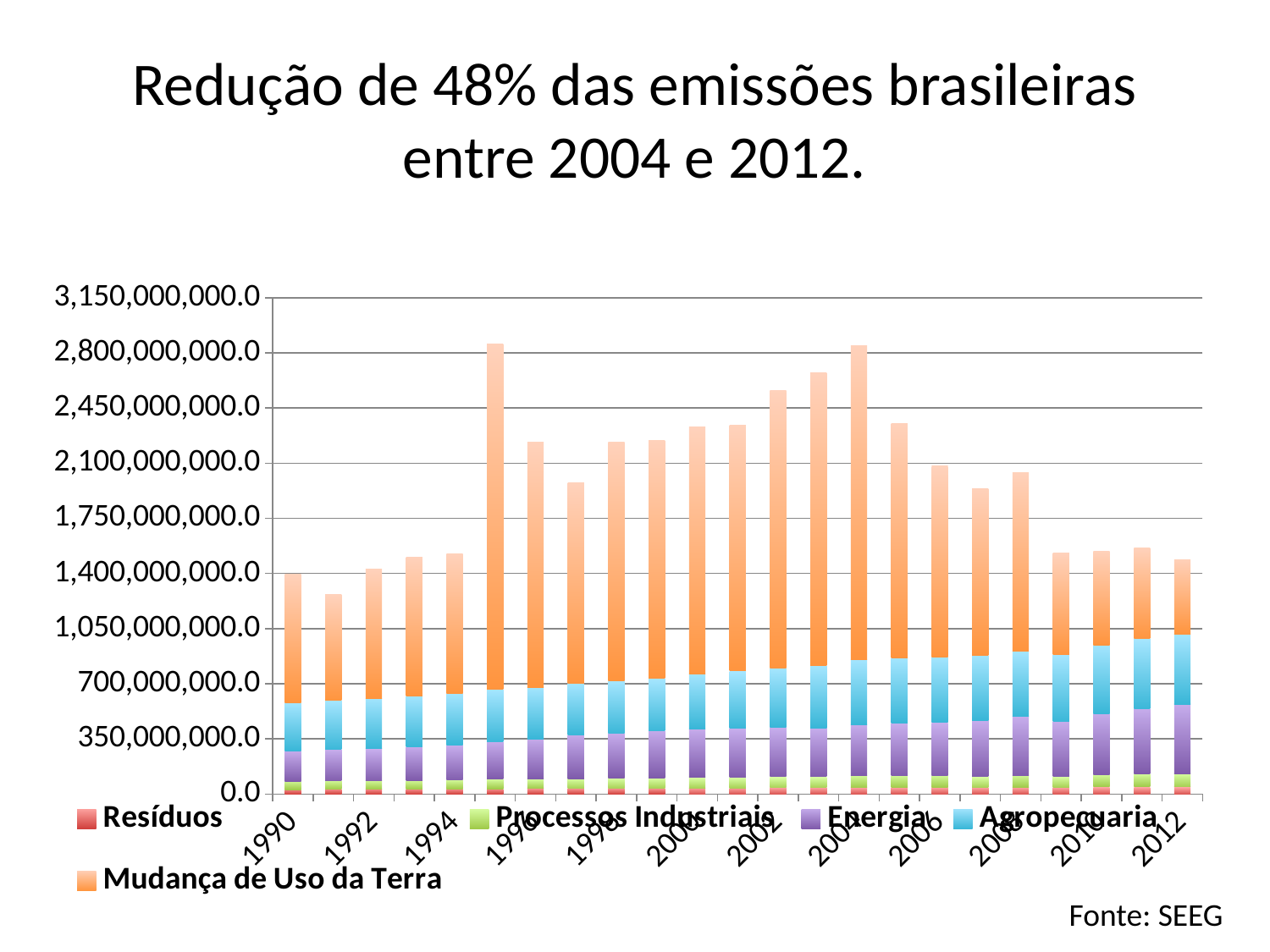
How many bars (years) are plotted in the chart? 23 What is the title of the slide? Redução de 48% das emissões brasileiras entre 2004 e 2012. Which year has the larger total emissions, 2004 or 2012? 2004 How many series does the legend list? 5 Is the total for 2012 greater or less than 1,750,000,000.0? less Do total emissions rise or fall from 2004 to 2012? fall Is the total for 1990 greater or less than 1,750,000,000.0? less Which year has the lowest total emissions in the chart? 1991 What kind of chart is shown on the slide? Stacked bar chart What source is cited for the chart? SEEG Which series contributes the largest share of the 2004 bar? Mudança de Uso da Terra Is the total for 2004 greater or less than 2,450,000,000.0? greater